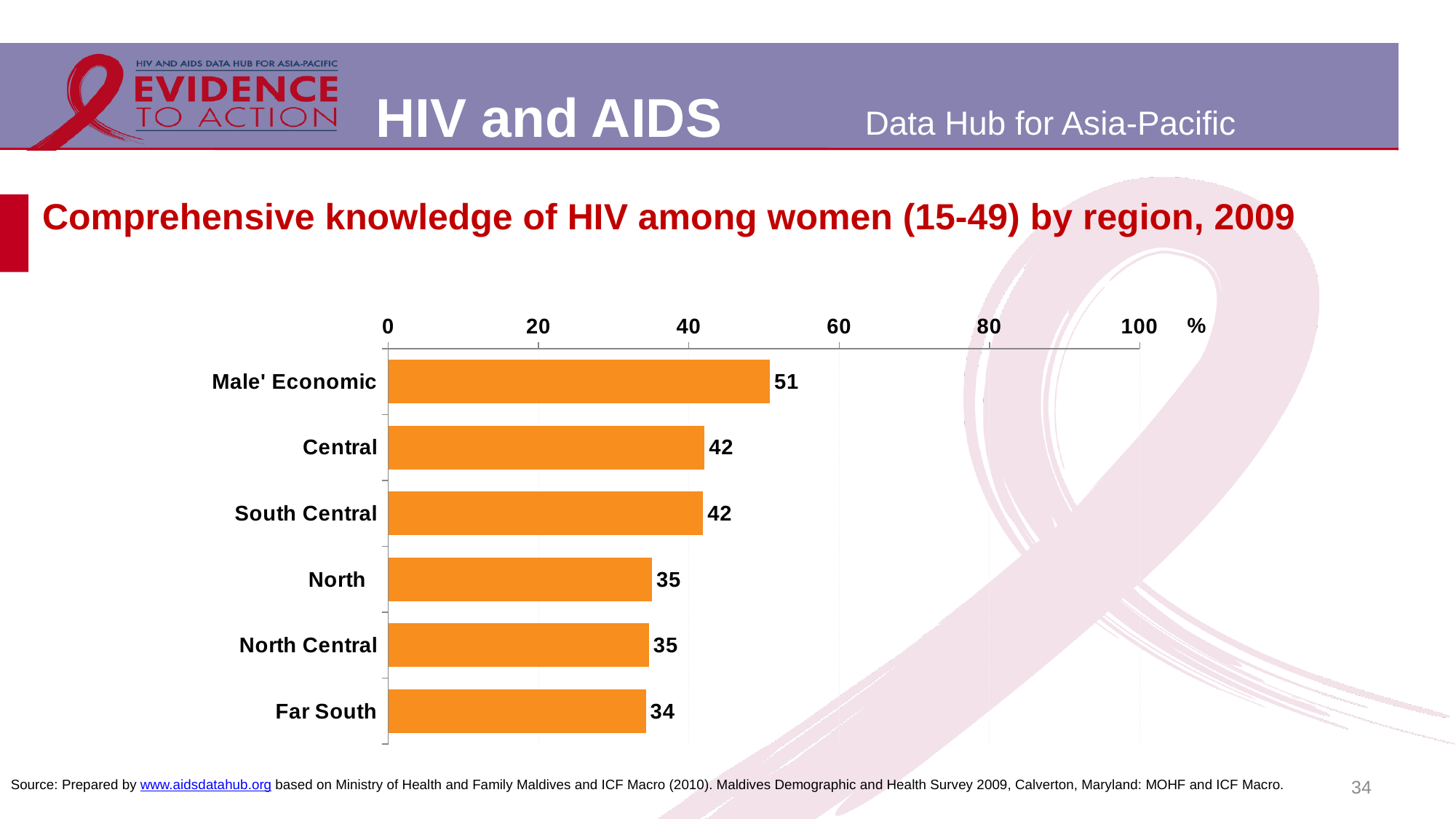
How many regions are shown in the chart? 6 Is the value for Male' Economic greater or less than 40? greater What unit is shown at the end of the horizontal axis? % What is the value for North Central? 35 What is the difference between the values for Male' Economic and Far South? 17 What is the value for Far South? 34 Which region has the highest value? Male' Economic Which region has the lowest value? Far South What is the difference between the values for Central and North? 7 What kind of chart is shown on the slide? bar chart Which is larger, the value for South Central or the value for North? South Central What is the value for Male' Economic? 51